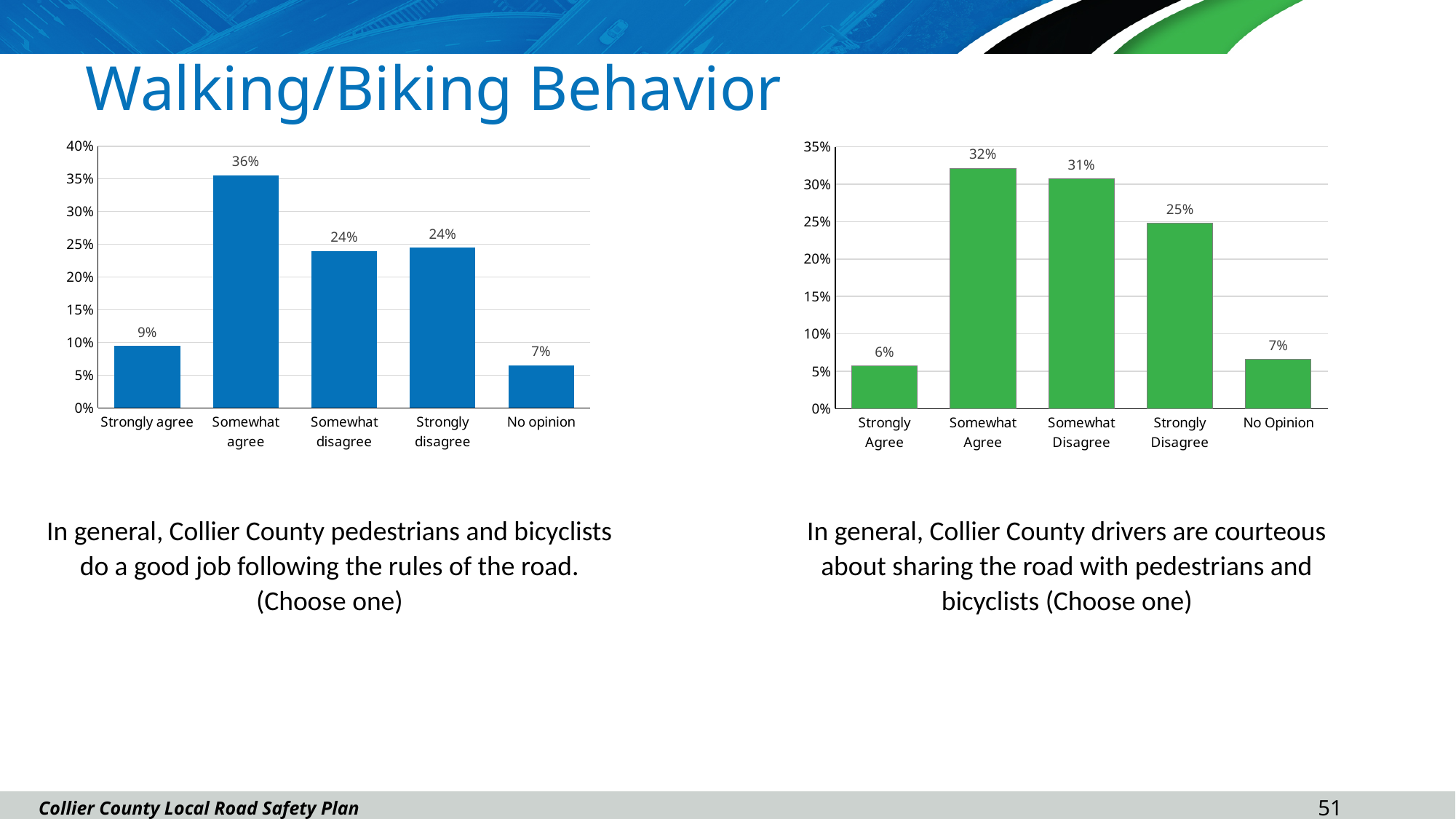
In the right chart (drivers are courteous about sharing the road), what percentage chose No Opinion? 7% In the right chart (drivers are courteous about sharing the road), is the value for Strongly Disagree greater or less than 20%? greater In the right chart (drivers are courteous about sharing the road), what is the difference between Somewhat Agree and Strongly Disagree? 7% In the right chart (drivers are courteous about sharing the road), which is larger: Strongly Disagree or Strongly Agree? Strongly Disagree In the left chart (pedestrians and bicyclists following the rules of the road), what percentage chose Strongly agree? 9% In the left chart (pedestrians and bicyclists following the rules of the road), which response has the lowest percentage? No opinion How many response categories are shown in the left chart (pedestrians and bicyclists following the rules of the road)? 5 In the left chart (pedestrians and bicyclists following the rules of the road), what is the difference between Somewhat agree and Strongly agree? 27% In the right chart (drivers are courteous about sharing the road), what percentage chose Somewhat Disagree? 31% What type of chart is the right chart (drivers are courteous about sharing the road)? Bar chart In the left chart (pedestrians and bicyclists following the rules of the road), what percentage chose Somewhat agree? 36% In the left chart (pedestrians and bicyclists following the rules of the road), which response has the highest percentage? Somewhat agree